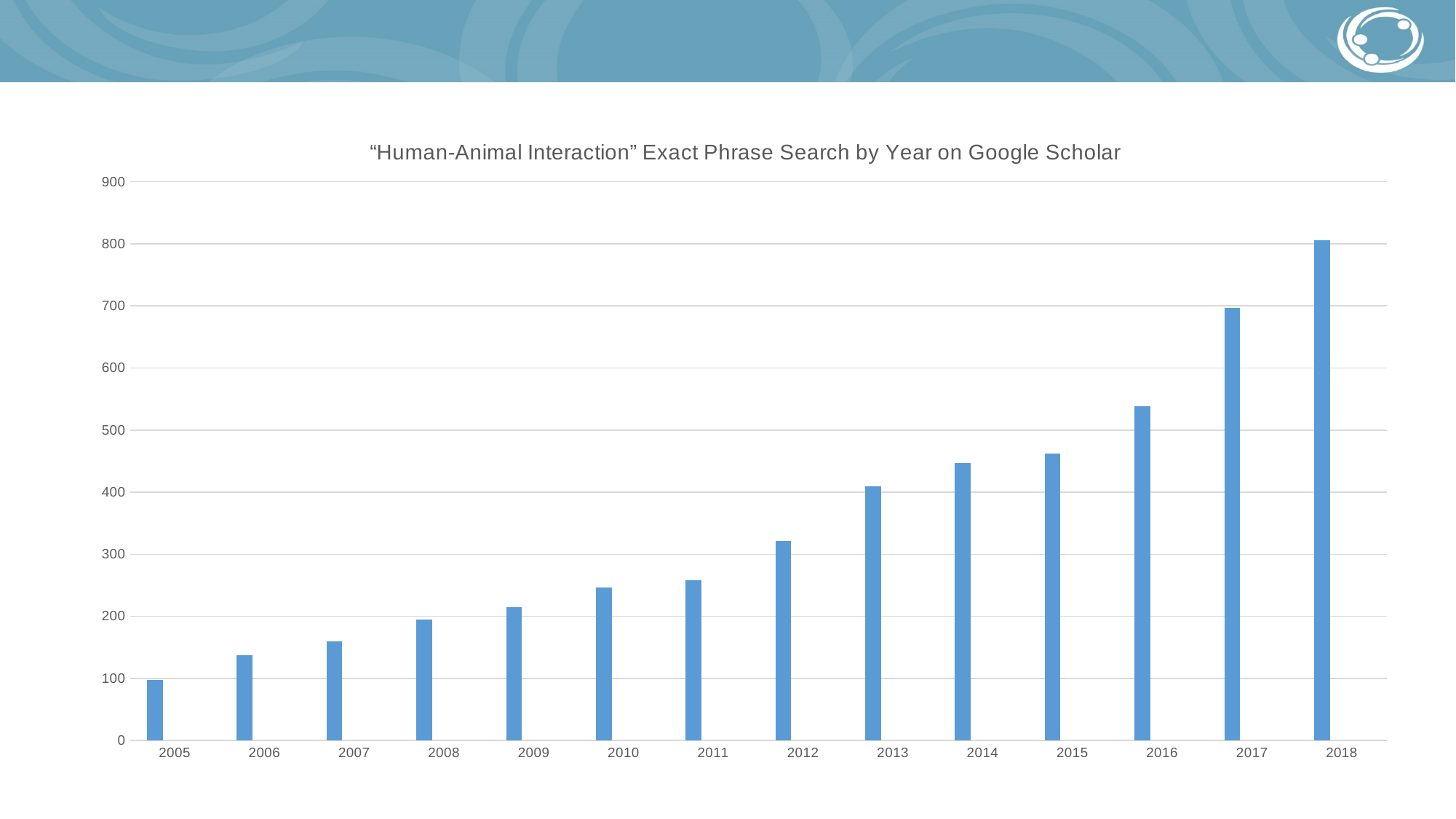
Do the values generally rise or fall from 2005 to 2018? rise Is the value for 2018 greater or less than 700? greater Which year has the highest bar? 2018 What is the title of the chart? “Human-Animal Interaction” Exact Phrase Search by Year on Google Scholar Is the value for 2016 greater or less than 500? greater Is the value for 2017 greater or less than 600? greater What kind of chart is shown on the slide? bar chart How many years are shown on the x axis of the chart? 14 Which year has the lowest bar? 2005 Which is larger, the value for 2016 or the value for 2017? 2017